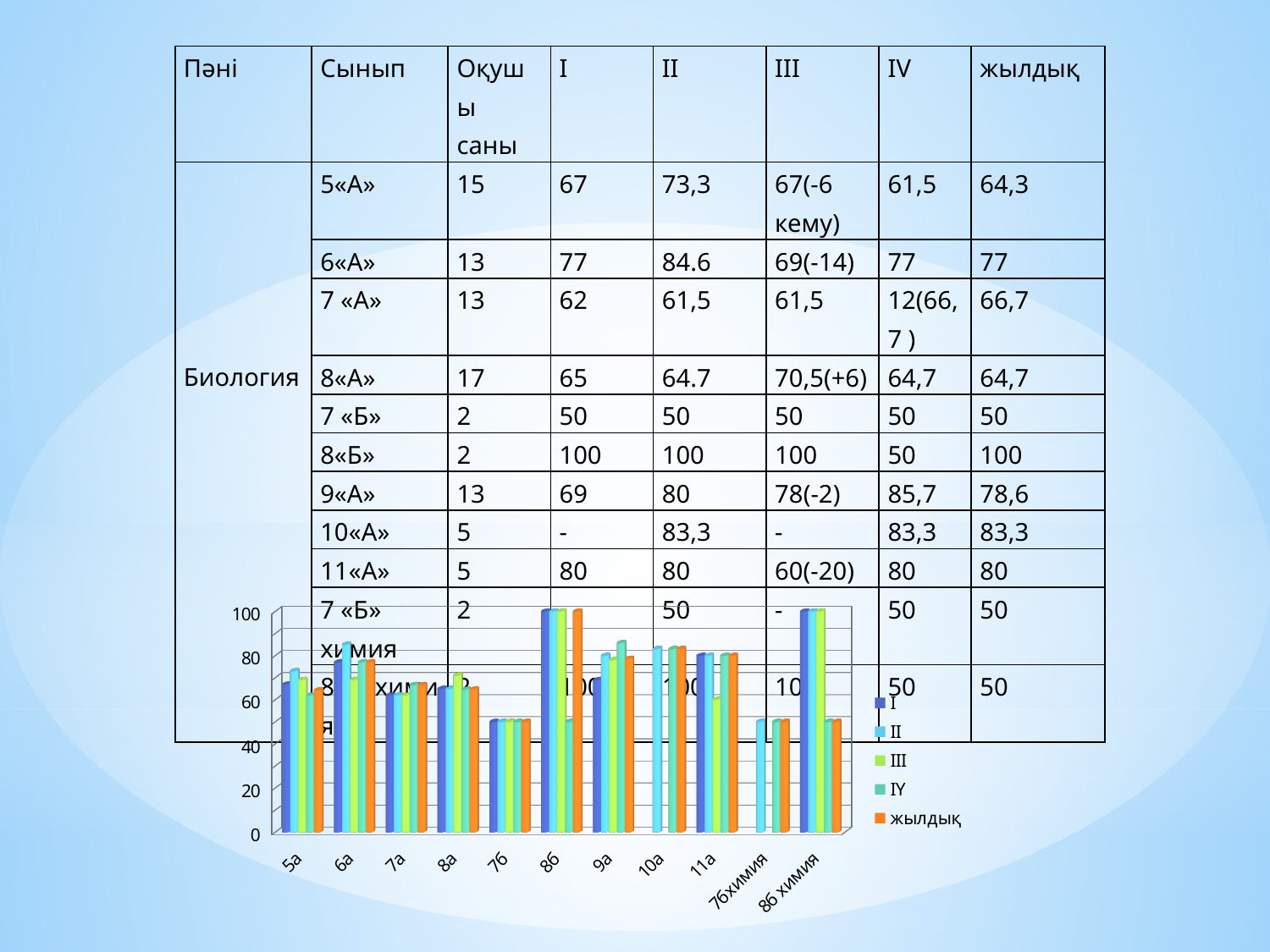
Which is larger in the chart: series I for 8б or series I for 7б? 8б Is the value of series II for 9а greater or less than 60? greater Is the value of series I for 7б greater or less than 60? less Is the value of series II for 10а greater or less than 60? greater What colour represents the series жылдық in the chart legend? orange What is the value of series I for category 8б in the chart? 100 How many categories are shown along the x axis of the chart? 11 How many series does the chart legend list? 5 What kind of chart is shown on the slide? bar chart Which is larger in the chart: series жылдық for 11а or series жылдық for 7б? 11а What is the value of series II for category 8б химия in the chart? 100